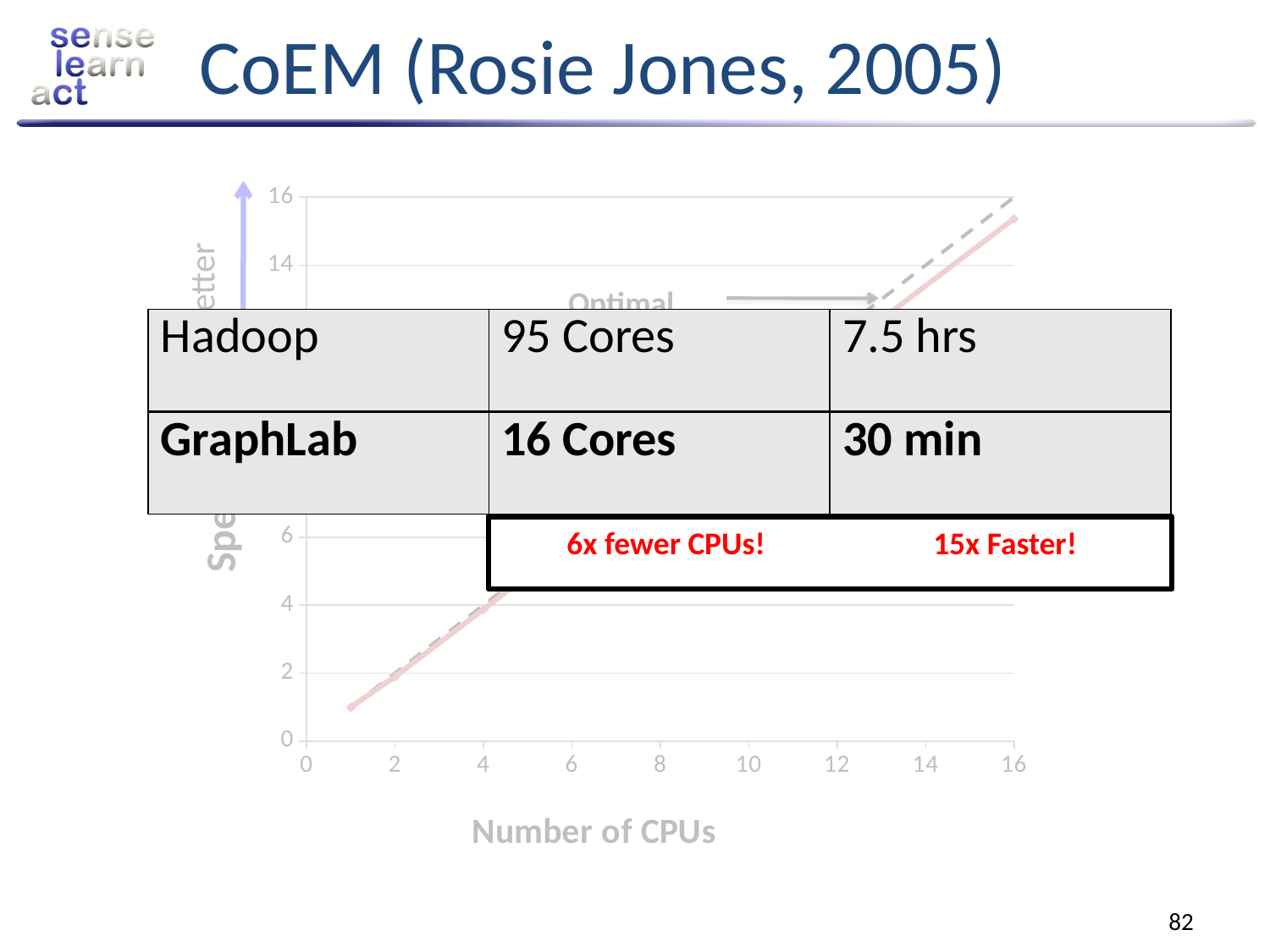
What label is attached to the dashed line in the chart? Optimal Is the value of the solid line at 1 CPU greater or less than 2? less Does the solid line in the chart rise or fall as the number of CPUs increases? rise What is the title of the x axis of the chart? Number of CPUs Is the value of the solid line at 16 CPUs greater or less than 14? greater Is the value of the solid line at 16 CPUs greater or less than 10? greater What kind of chart is shown on the slide behind the table? line chart